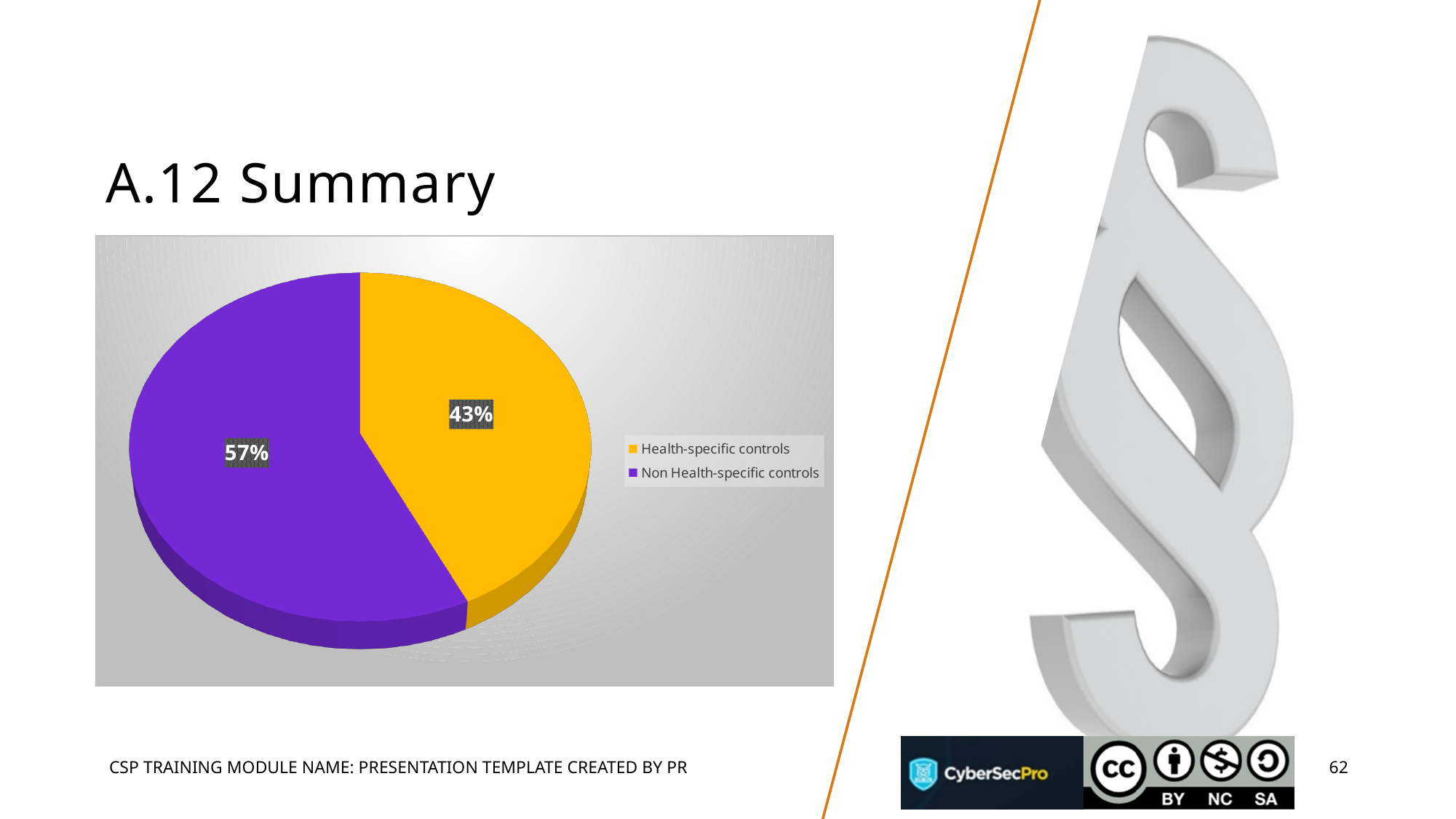
How many entries does the legend list? 2 How many slices does the pie chart have? 2 What kind of chart is shown on the slide? Pie chart Is the share for Health-specific controls greater or less than 50%? less What colour is the Health-specific controls slice? Yellow What is the difference in percentage points between Non Health-specific controls and Health-specific controls? 14 Which is larger: the share for Health-specific controls or Non Health-specific controls? Non Health-specific controls What colour is the Non Health-specific controls slice? Purple What percentage of the pie is Non Health-specific controls? 57% Which category has the smallest share of the pie? Health-specific controls What percentage of the pie is Health-specific controls? 43% Which category has the largest share of the pie? Non Health-specific controls